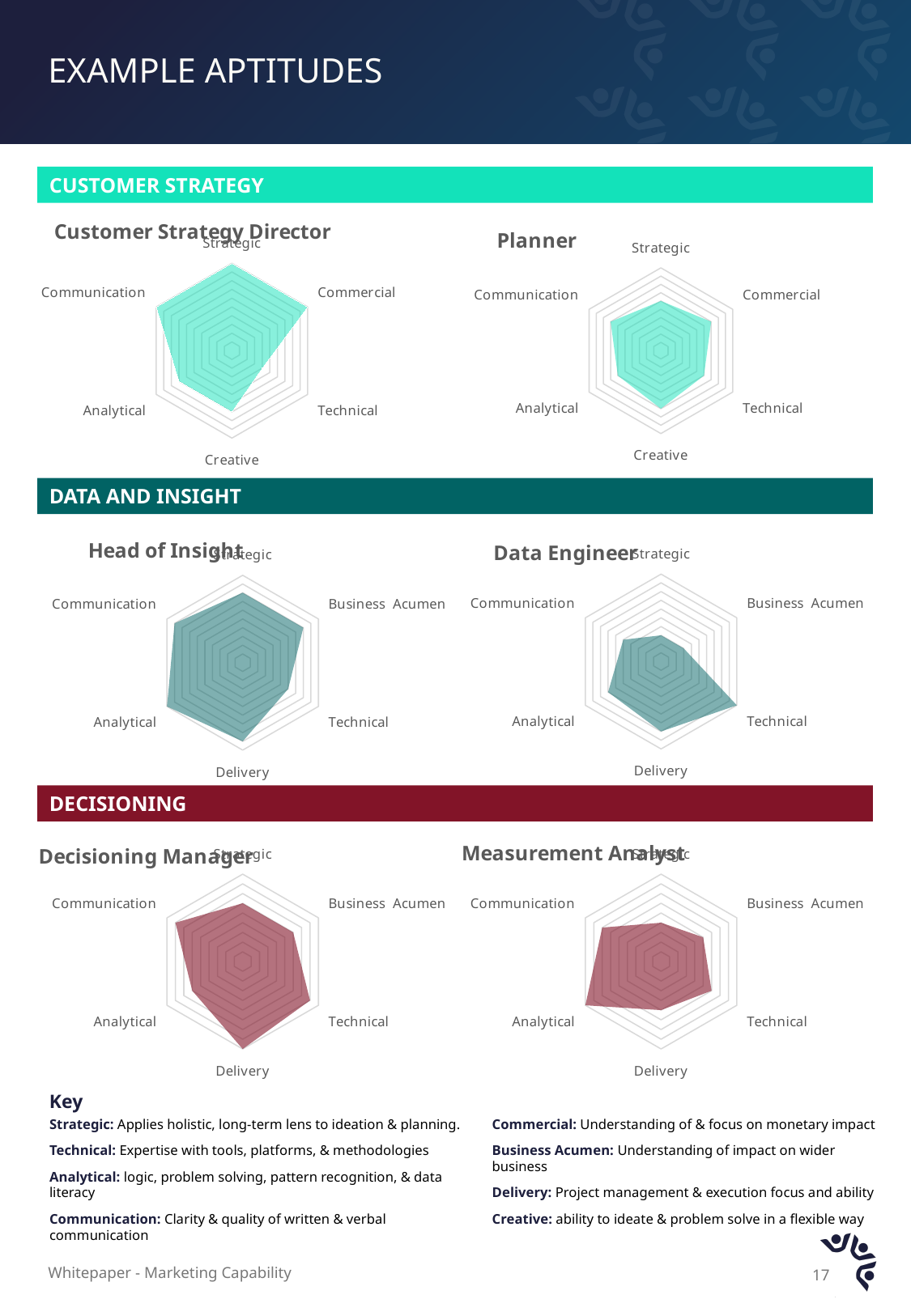
How many aptitude axes does the Planner chart have? 6 Which axis label appears in the Customer Strategy charts but not in the Data and Insight charts? Commercial and Creative In the Measurement Analyst chart, which aptitude has the highest value? Analytical In the Customer Strategy Director chart, which is larger, Strategic or Analytical? Strategic What kind of chart is the Customer Strategy Director chart? Radar chart In the Measurement Analyst chart, which is larger, Analytical or Delivery? Analytical In the Data Engineer chart, which aptitude has the highest value? Technical In the Data Engineer chart, which is larger, Technical or Strategic? Technical Which two charts appear under the Data and Insight section? Head of Insight and Data Engineer In the Customer Strategy Director chart, which aptitude has the lowest value? Technical How many radar charts are shown on the slide? 6